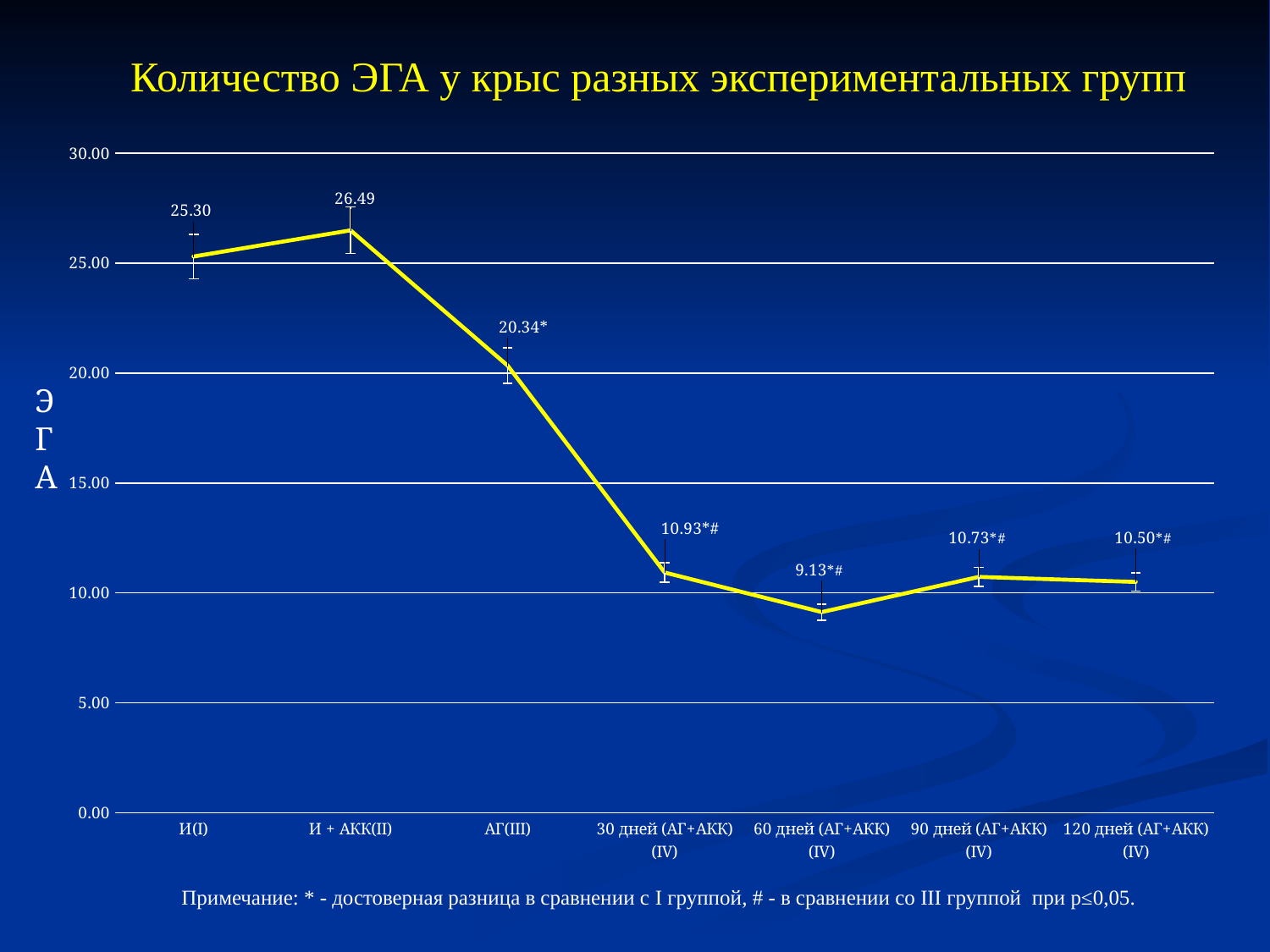
What is the title of the chart? Количество ЭГА у крыс разных экспериментальных групп What kind of chart is shown on the slide? line chart How many groups are plotted along the x axis? 7 Which is larger, the value for 90 дней (АГ+АКК) (IV) or for 120 дней (АГ+АКК) (IV)? 90 дней (АГ+АКК) (IV) What is the value for the АГ(III) group? 20.34* What is the difference between the values for 30 дней (АГ+АКК) (IV) and 60 дней (АГ+АКК) (IV)? 1.80 What is the value for the И + АКК(II) group? 26.49 What is the difference between the values for И + АКК(II) and И(I)? 1.19 Is the value for И(I) greater or less than 25? greater Which group has the lowest value? 60 дней (АГ+АКК) (IV) Which group has the highest value? И + АКК(II) What is the value for the 60 дней (АГ+АКК) (IV) group? 9.13*#